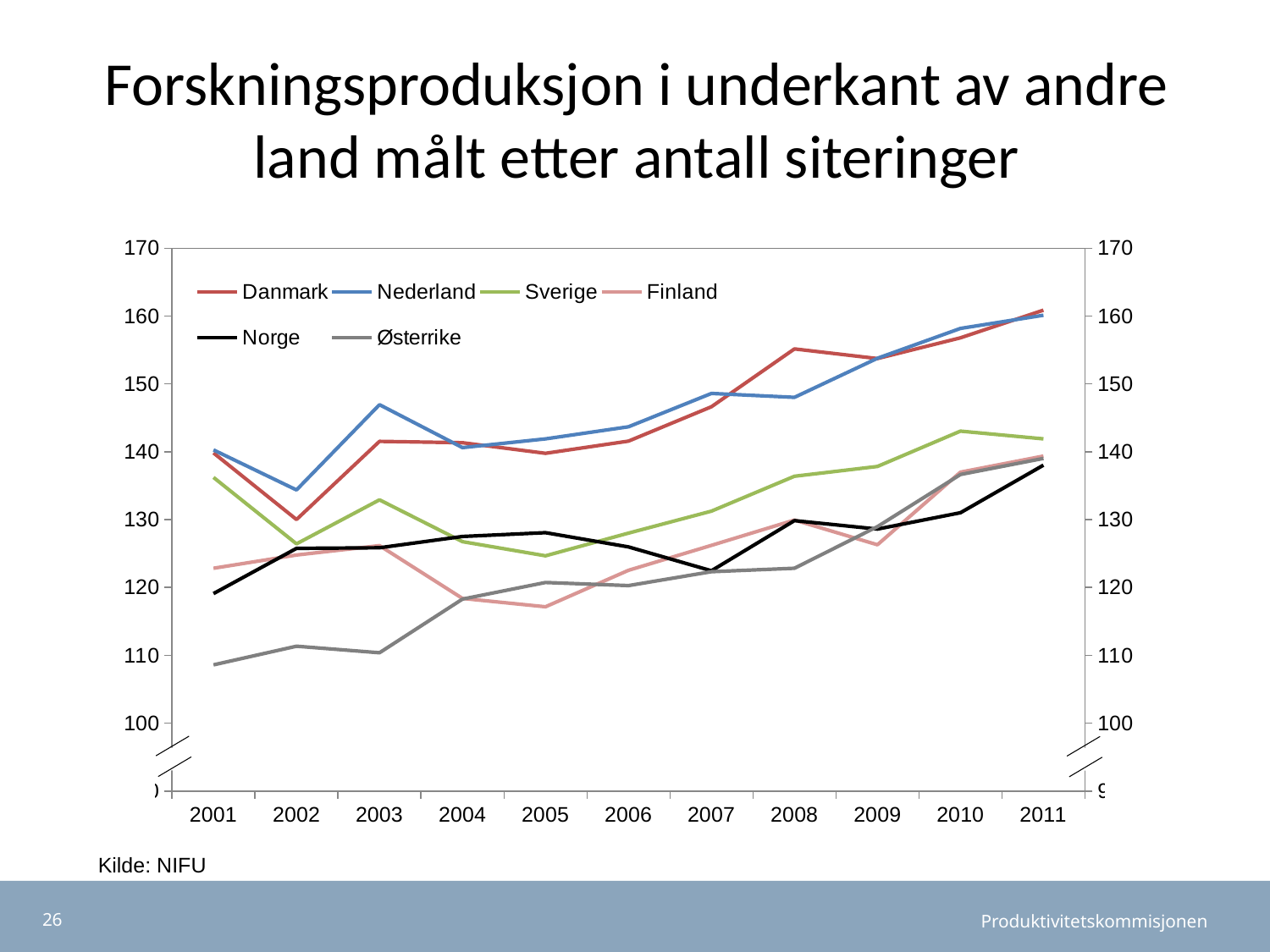
Which country has the lowest value in 2001? Østerrike Is the value for Finland in 2005 greater or less than 120? less Is the value for Danmark in 2008 greater or less than 150? greater How many series does the legend list? 6 Which country has the highest value in 2003? Nederland What source is cited below the chart? Kilde: NIFU Does the value for Østerrike rise or fall from 2001 to 2011? rise What kind of chart is shown on the slide? line chart How many years are shown along the x axis? 11 Is the value for Østerrike in 2001 greater or less than 110? less In 2003, which is larger: the value for Finland or the value for Østerrike? Finland In 2011, which is larger: the value for Danmark or the value for Sverige? Danmark